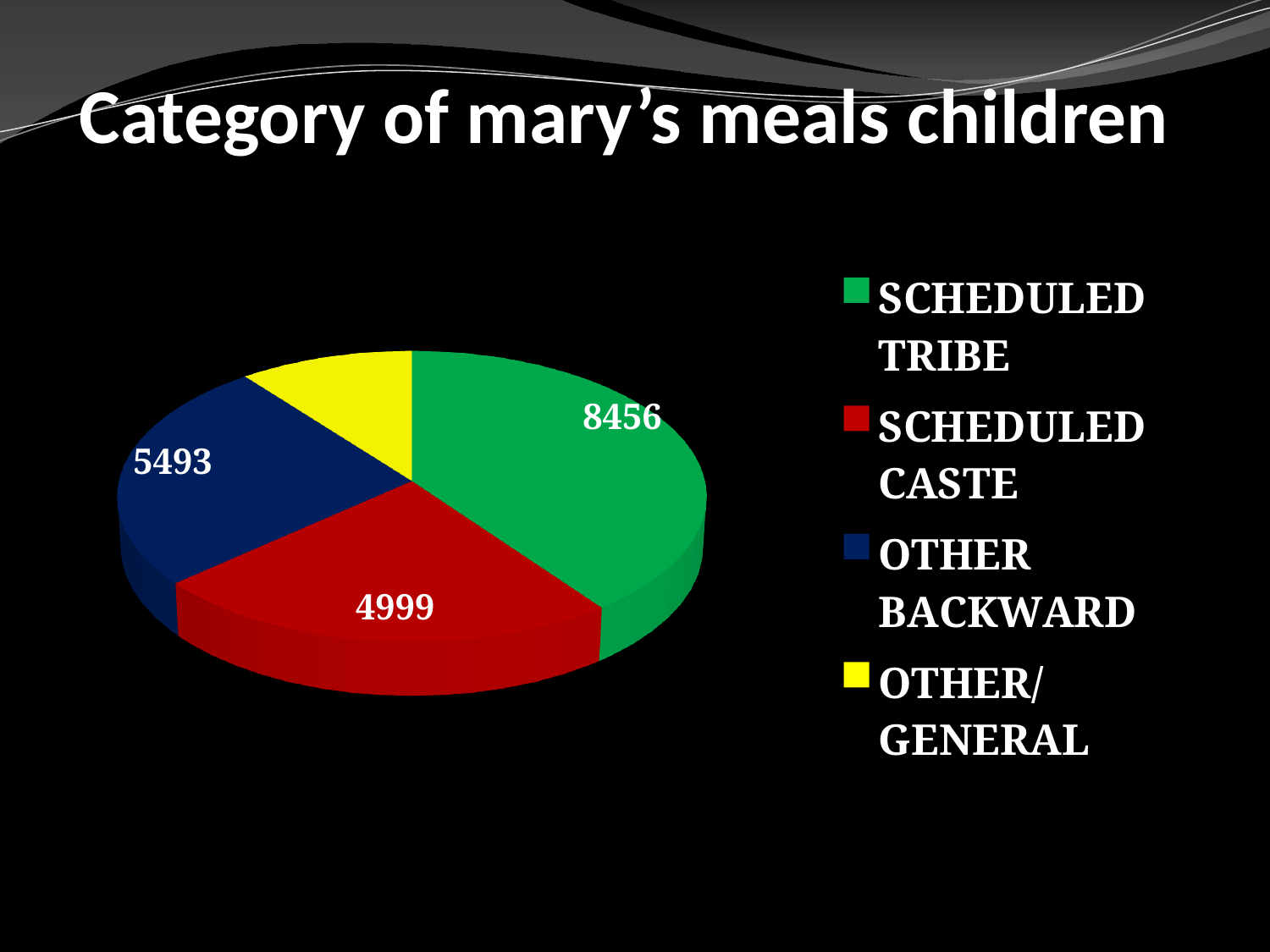
What kind of chart is shown on the slide? pie chart What is the value for Other Backward? 5493 What is the value for Scheduled Tribe? 8456 Which category has the smallest slice of the pie? Other/General What is the difference between the values for Scheduled Tribe and Scheduled Caste? 3457 What colour is the Scheduled Caste slice? red What is the value for Scheduled Caste? 4999 What is the difference between the values for Other Backward and Scheduled Caste? 494 How many categories does the pie chart show? 4 Which is larger, the value for Other Backward or the value for Scheduled Caste? Other Backward Which category has the largest slice of the pie? Scheduled Tribe What is the title of the slide? Category of mary's meals children